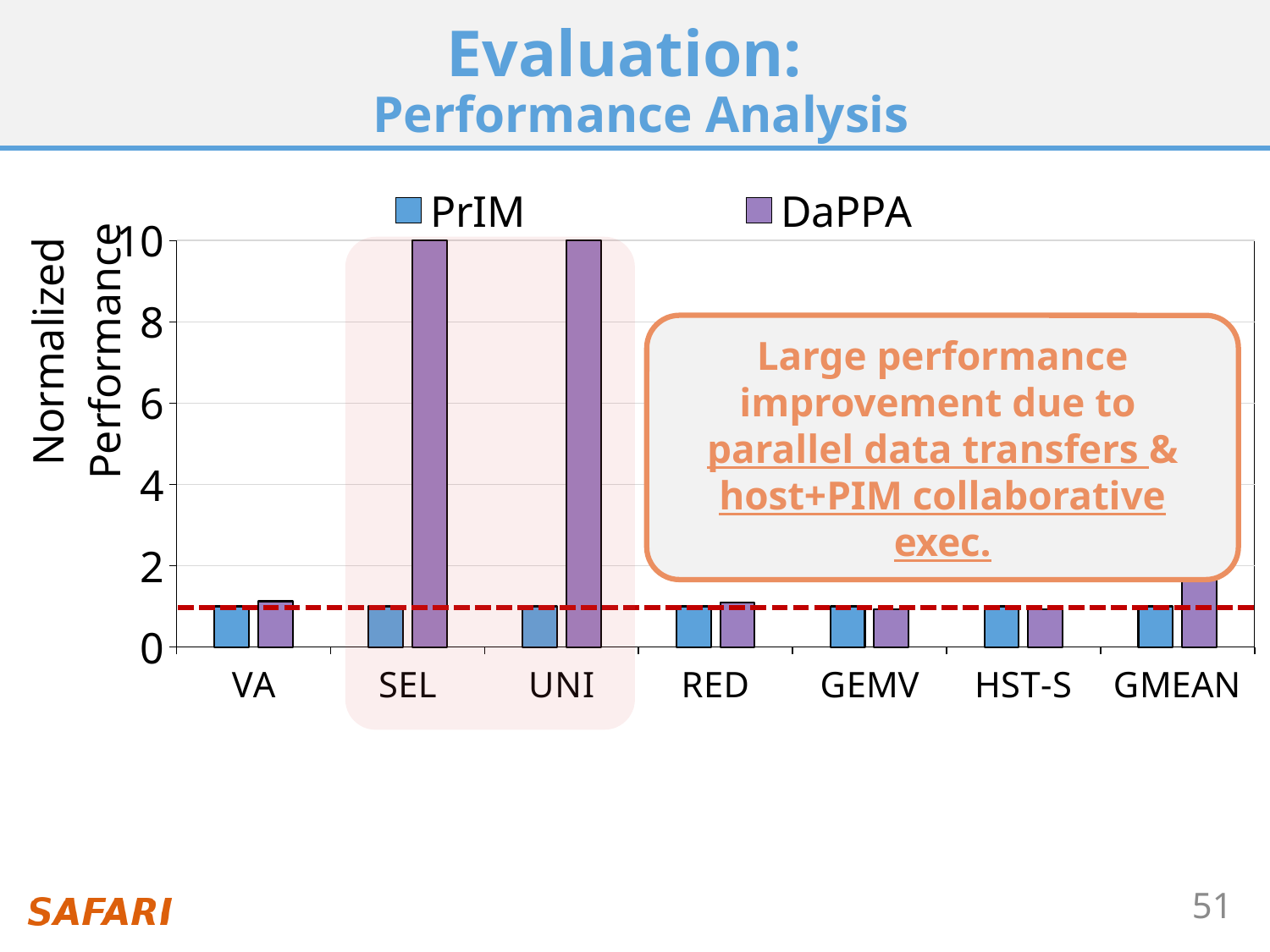
What is the label of the y axis? Normalized Performance Is the PrIM value for RED greater or less than 2? less Is the DaPPA value for SEL greater or less than the DaPPA value for RED? greater For GMEAN, which series has the larger value, PrIM or DaPPA? DaPPA Is the DaPPA value for SEL greater or less than 8? greater Is the DaPPA value for UNI greater or less than 6? greater How many series does the legend list? 2 What kind of chart is shown on the slide? bar chart How many categories are shown on the x axis? 7 Which series is shown in purple in the legend? DaPPA